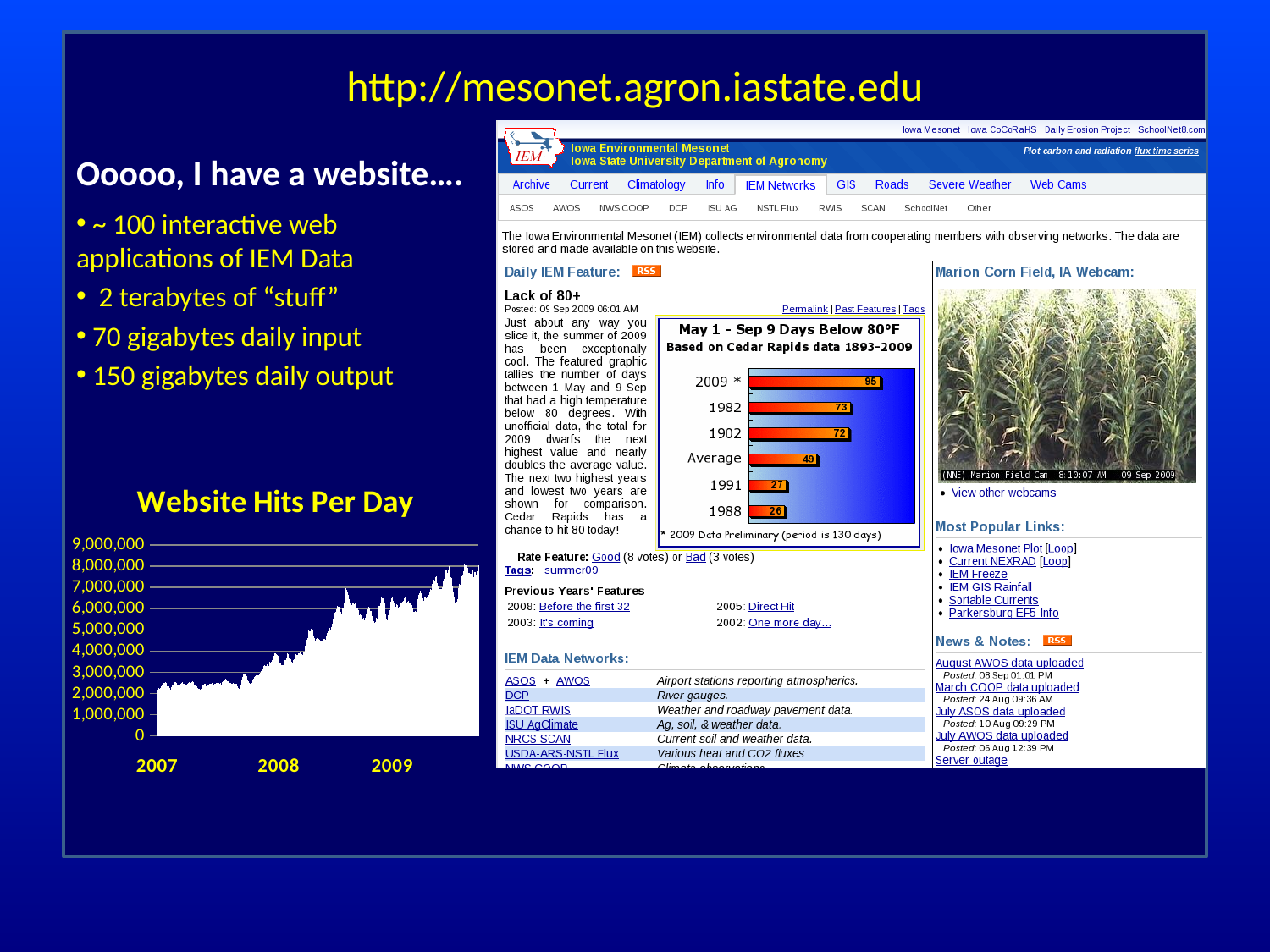
In the 'May 1 - Sep 9 Days Below 80°F' chart, what is the value for 1982? 73 In the 'May 1 - Sep 9 Days Below 80°F' chart, what is the difference between the values for 2009 and 1982? 22 In the 'Website Hits Per Day' chart, do the values generally rise or fall from 2007 to 2009? Rise In the 'May 1 - Sep 9 Days Below 80°F' chart, which is larger, the value for 1982 or the value for 1902? 1982 In the 'May 1 - Sep 9 Days Below 80°F' chart, what is the value labelled 'Average'? 49 In the 'Website Hits Per Day' chart, what is the highest value shown on the vertical axis? 9,000,000 In the 'May 1 - Sep 9 Days Below 80°F' chart, what is the value for 2009? 95 How many bars are shown in the 'May 1 - Sep 9 Days Below 80°F' chart? 6 In the 'May 1 - Sep 9 Days Below 80°F' chart, which category has the highest value? 2009 In the 'Website Hits Per Day' chart, is the value at the start of 2007 greater or less than 3,000,000? less In the 'May 1 - Sep 9 Days Below 80°F' chart, which category has the lowest value? 1988 What kind of chart is the 'May 1 - Sep 9 Days Below 80°F' chart? Bar chart